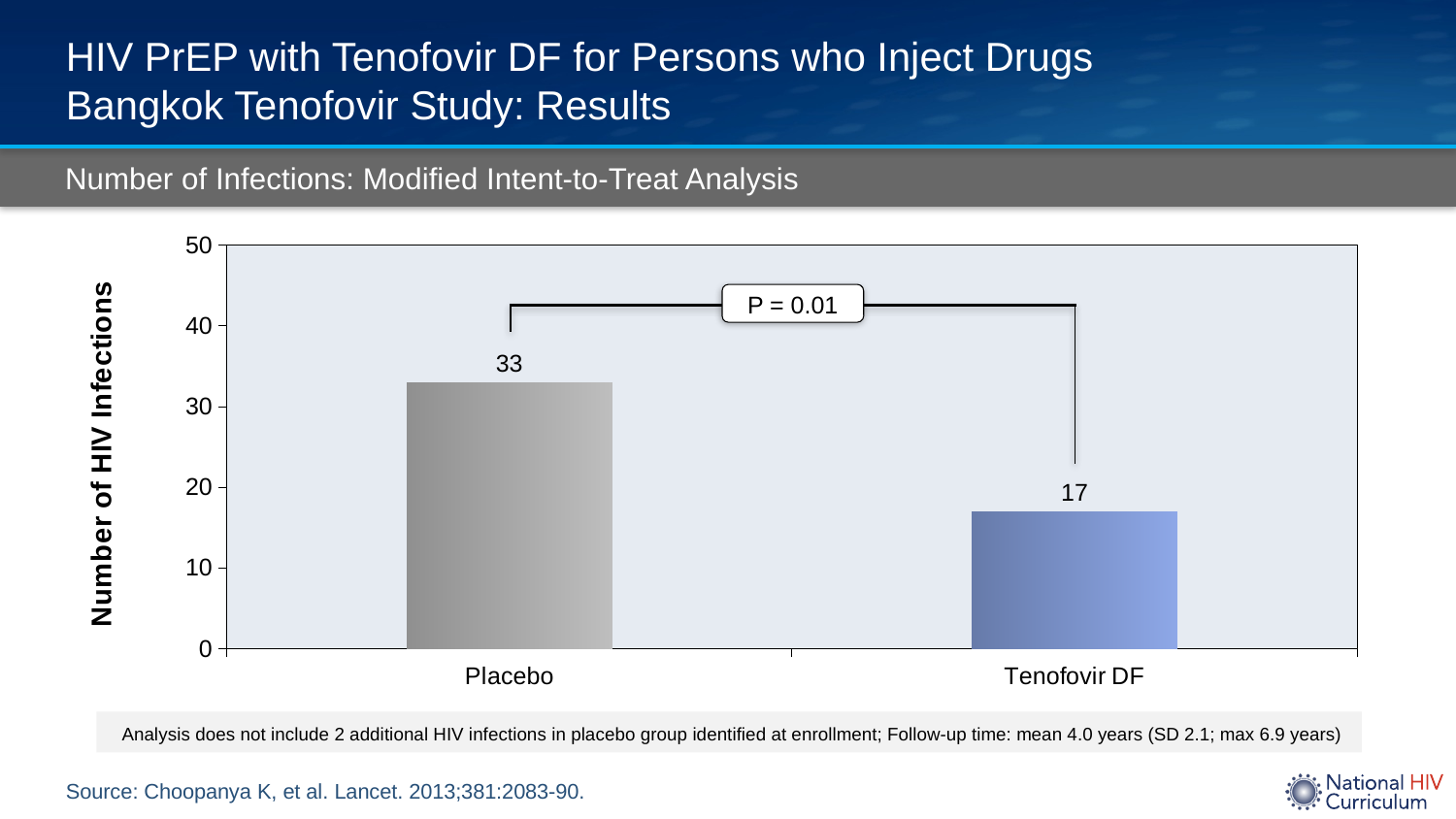
Is the number of HIV infections for Tenofovir DF greater or less than 20? less What kind of chart is shown on the slide? Bar chart What is the label of the y-axis? Number of HIV Infections Which group has the lowest number of HIV infections? Tenofovir DF Which group has more HIV infections, Placebo or Tenofovir DF? Placebo What is the difference in the number of HIV infections between the Placebo and Tenofovir DF groups? 16 How many groups are shown on the chart? 2 What is the number of HIV infections for the Tenofovir DF group? 17 What is the number of HIV infections for the Placebo group? 33 What P value is shown on the chart comparing the two groups? P = 0.01 Which group has the highest number of HIV infections? Placebo Is the number of HIV infections for Placebo greater or less than 30? greater